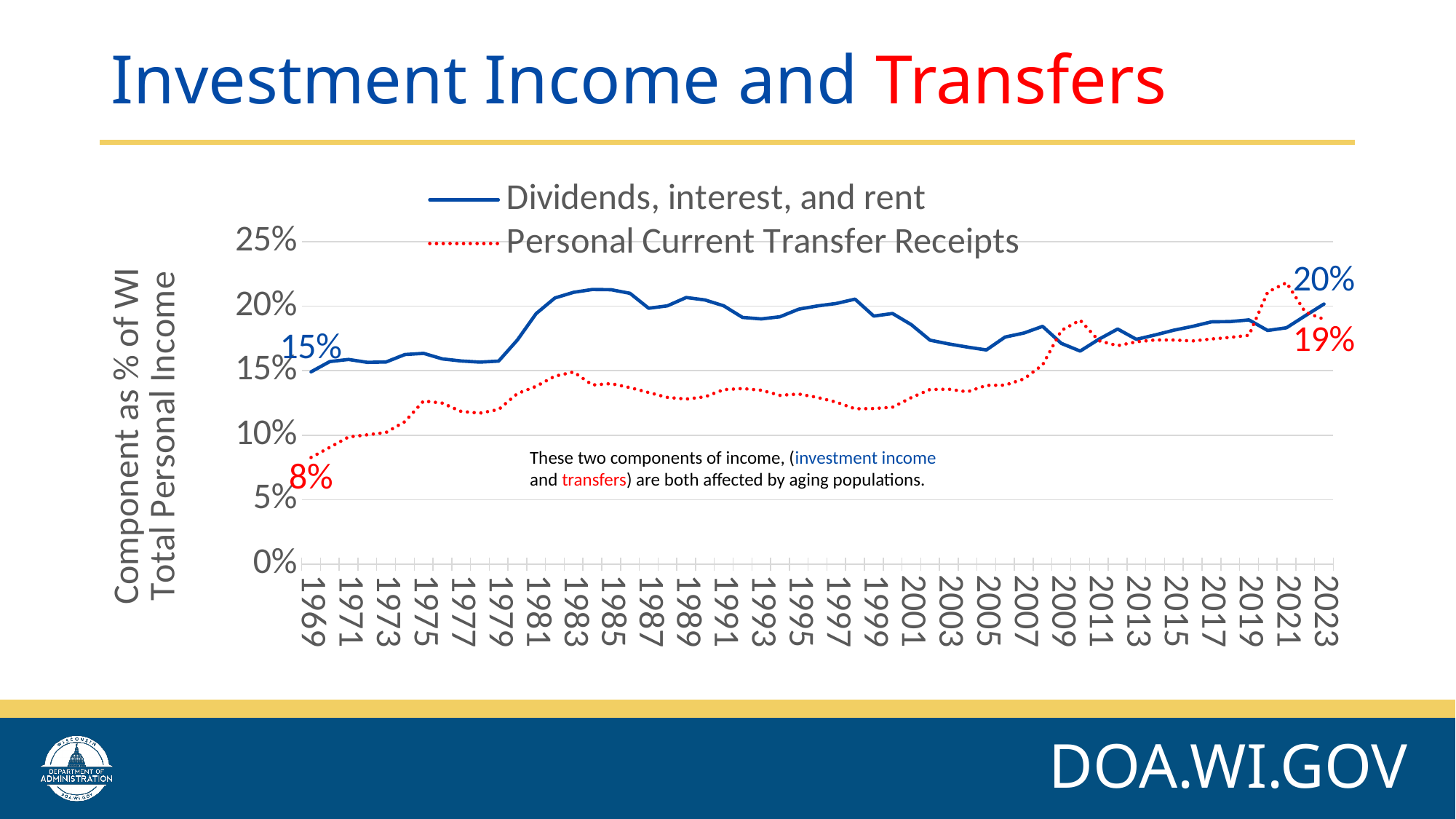
Which series has the higher value in 1969, Dividends, interest, and rent or Personal Current Transfer Receipts? Dividends, interest, and rent Does the Personal Current Transfer Receipts series generally rise or fall from 1969 to 2023? rise Is the value for Personal Current Transfer Receipts in 1999 greater or less than 15%? less What is the difference between the 1969 values of Dividends, interest, and rent and Personal Current Transfer Receipts? 7% What is the value for Dividends, interest, and rent in 1969? 15% What is the y-axis label of the chart? Component as % of WI Total Personal Income How many series does the legend list? 2 What is the value for Personal Current Transfer Receipts in 2023? 19% What is the value for Personal Current Transfer Receipts in 1969? 8% What is the value for Dividends, interest, and rent in 2023? 20% By how much did Personal Current Transfer Receipts rise from 1969 to 2023? 11% What kind of chart is shown on the slide? line chart